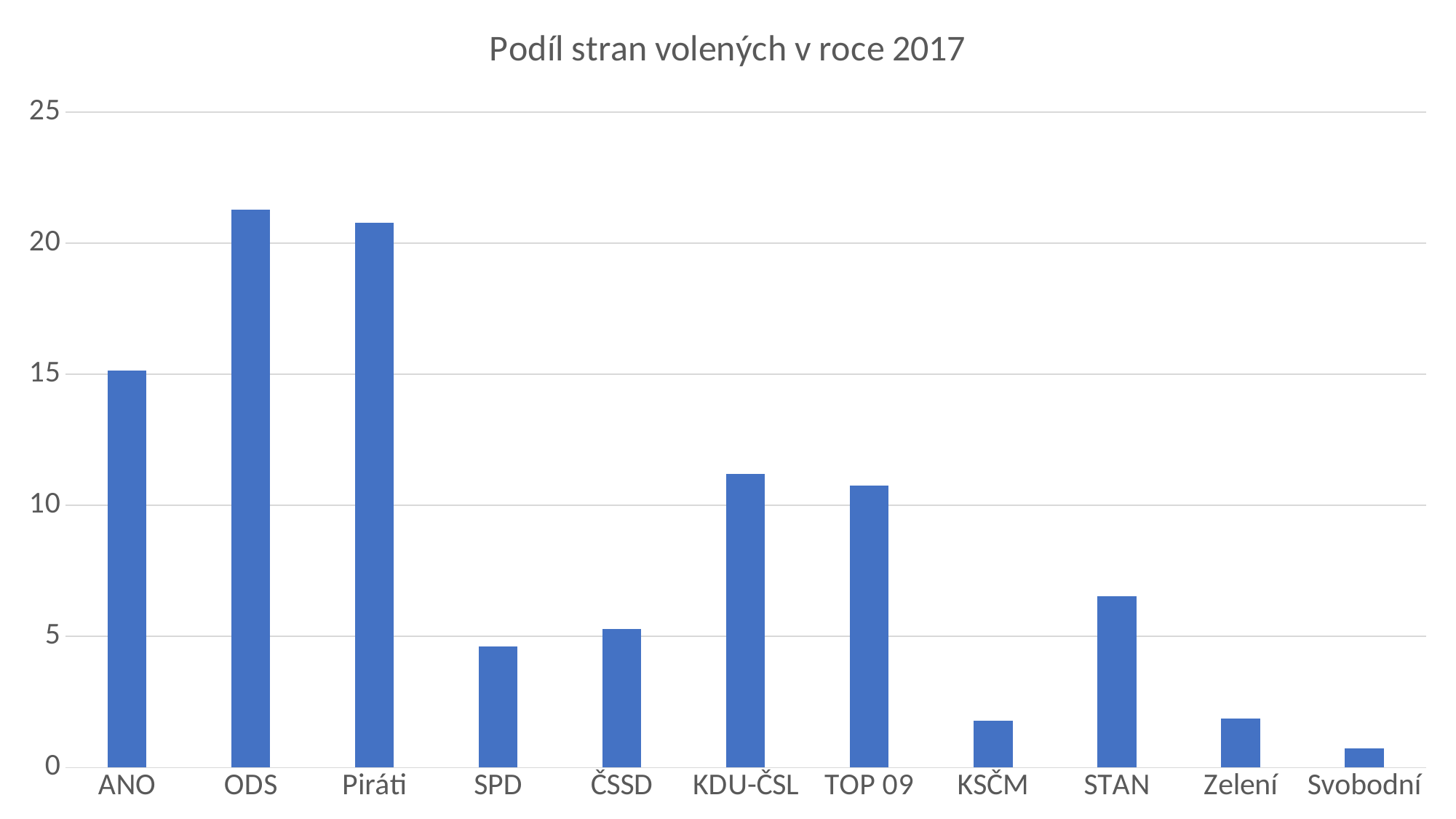
Which party has the highest bar? ODS How many parties (categories) are shown on the x axis? 11 Is the value for SPD greater or less than 5? less Which is larger, the value for STAN or the value for ČSSD? STAN What kind of chart is shown on the slide? bar chart Is the value for KDU-ČSL greater or less than 10? greater Is the value for ANO greater or less than 20? less What is the title of the chart? Podíl stran volených v roce 2017 Which is larger, the value for ANO or the value for KDU-ČSL? ANO Which party has the lowest bar? Svobodní